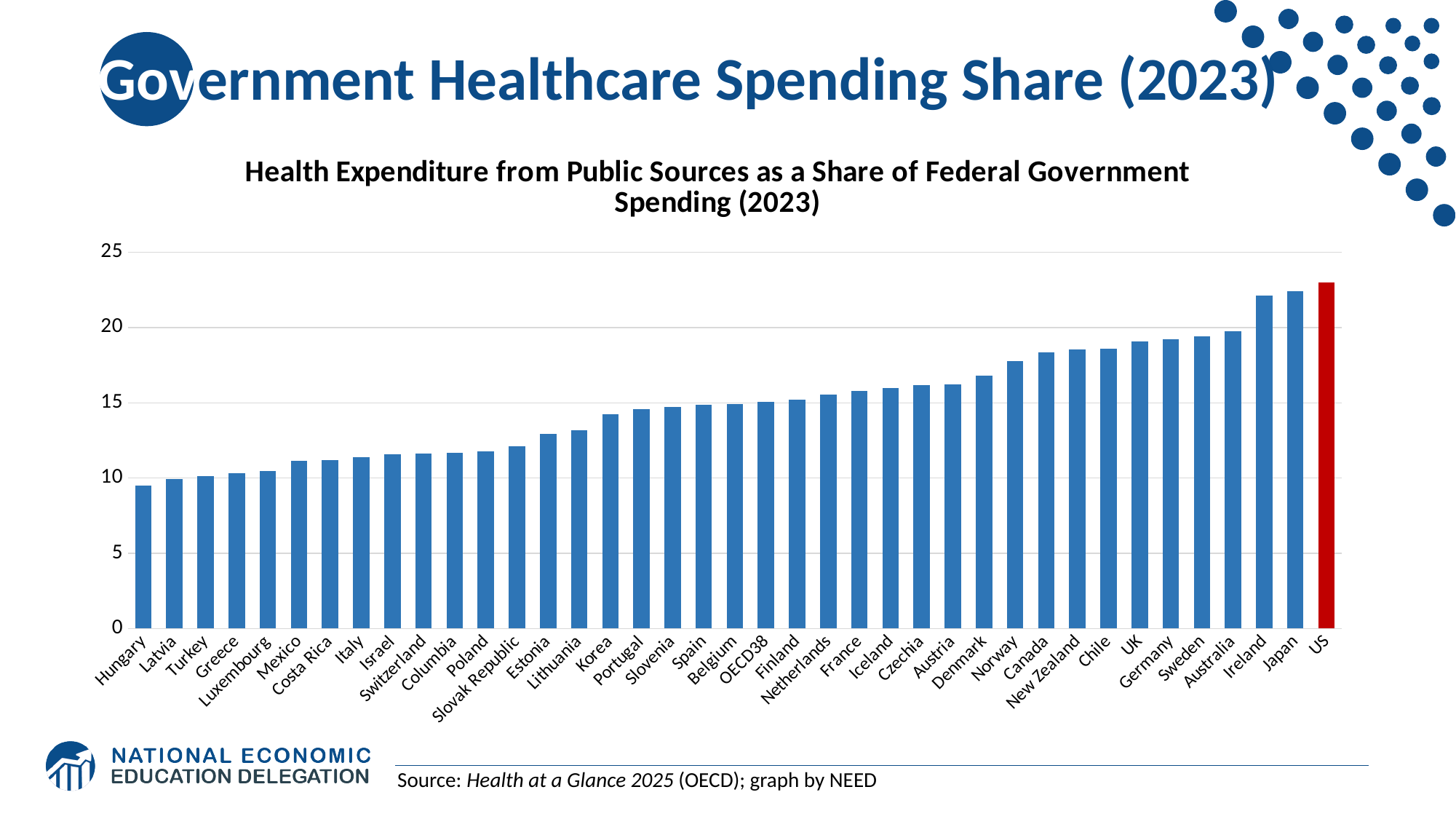
Which country has the lowest health expenditure share in the chart? Hungary Which has a larger value, Germany or Korea? Germany Do the bar values rise or fall moving from left to right along the x axis? Rise How many bars (countries/groups) are plotted in the chart? 39 What kind of chart is shown on the slide? Bar chart Is the value for Korea greater or less than 15? less Is the value for Hungary greater or less than 10? less Which has a larger value, Latvia or Japan? Japan Which country's bar is coloured red instead of blue? US Is the value for Norway greater or less than 15? greater Which country has the highest health expenditure share in the chart? US